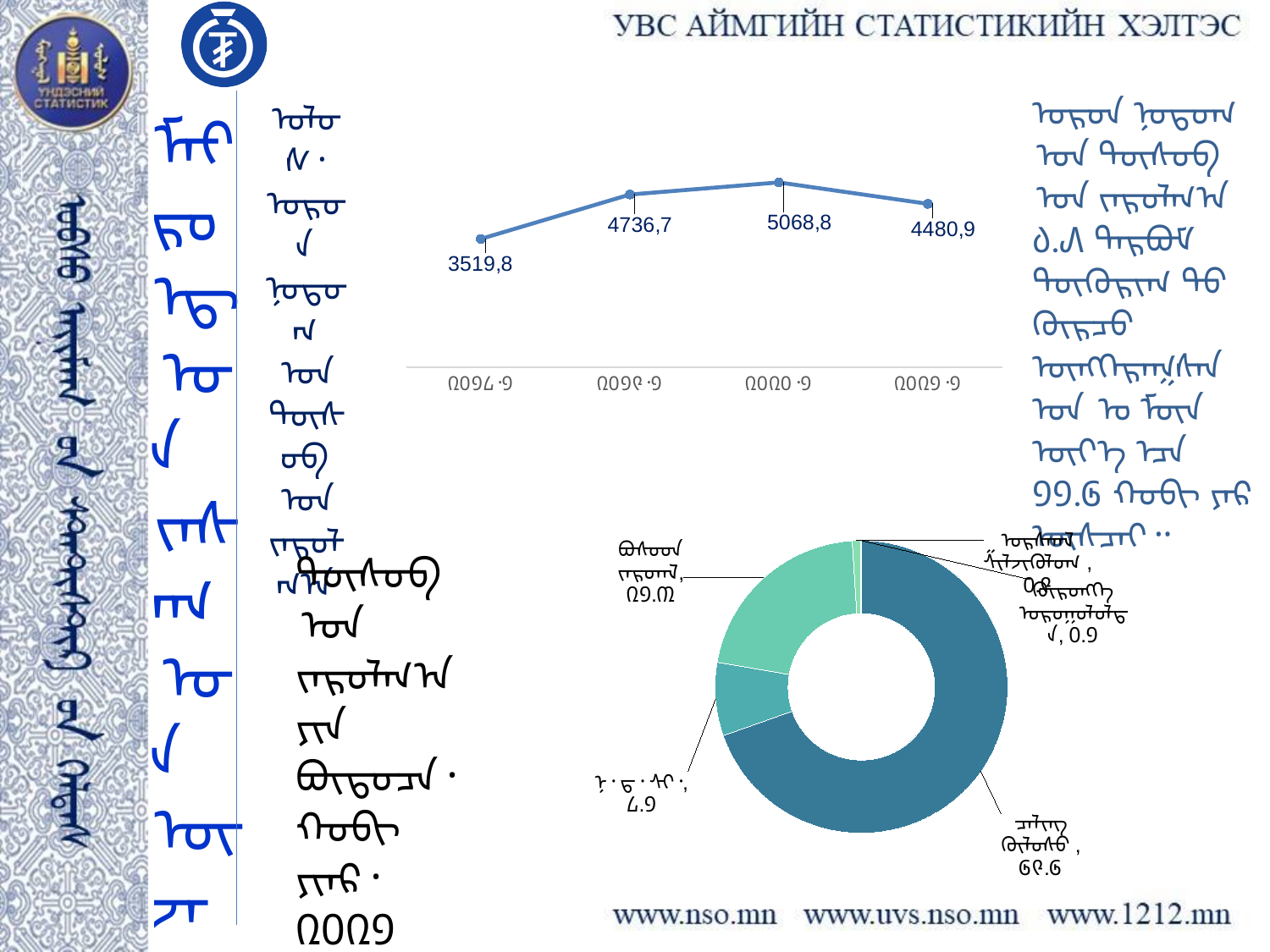
In the line chart at the top, what is the highest plotted value? 5068,8 In the line chart at the top, what is the value of the first (leftmost) point? 3519,8 In the line chart at the top, how many data points are plotted? 4 In the line chart at the top, what is the difference between the highest value (5068,8) and the lowest value (3519,8)? 1549,0 What kind of chart is the chart at the top of the slide? line chart In the line chart at the top, which is larger: the second point (4736,7) or the last point (4480,9)? the second point, 4736,7 In the line chart at the top, what is the value of the second point? 4736,7 What kind of chart is the chart at the bottom of the slide? doughnut (pie) chart In the line chart at the top, what is the value of the third point? 5068,8 In the line chart at the top, what is the lowest plotted value? 3519,8 In the line chart at the top, what is the value of the last (rightmost) point? 4480,9 In the line chart at the top, how do the values change from left to right? they rise to the third point, then fall